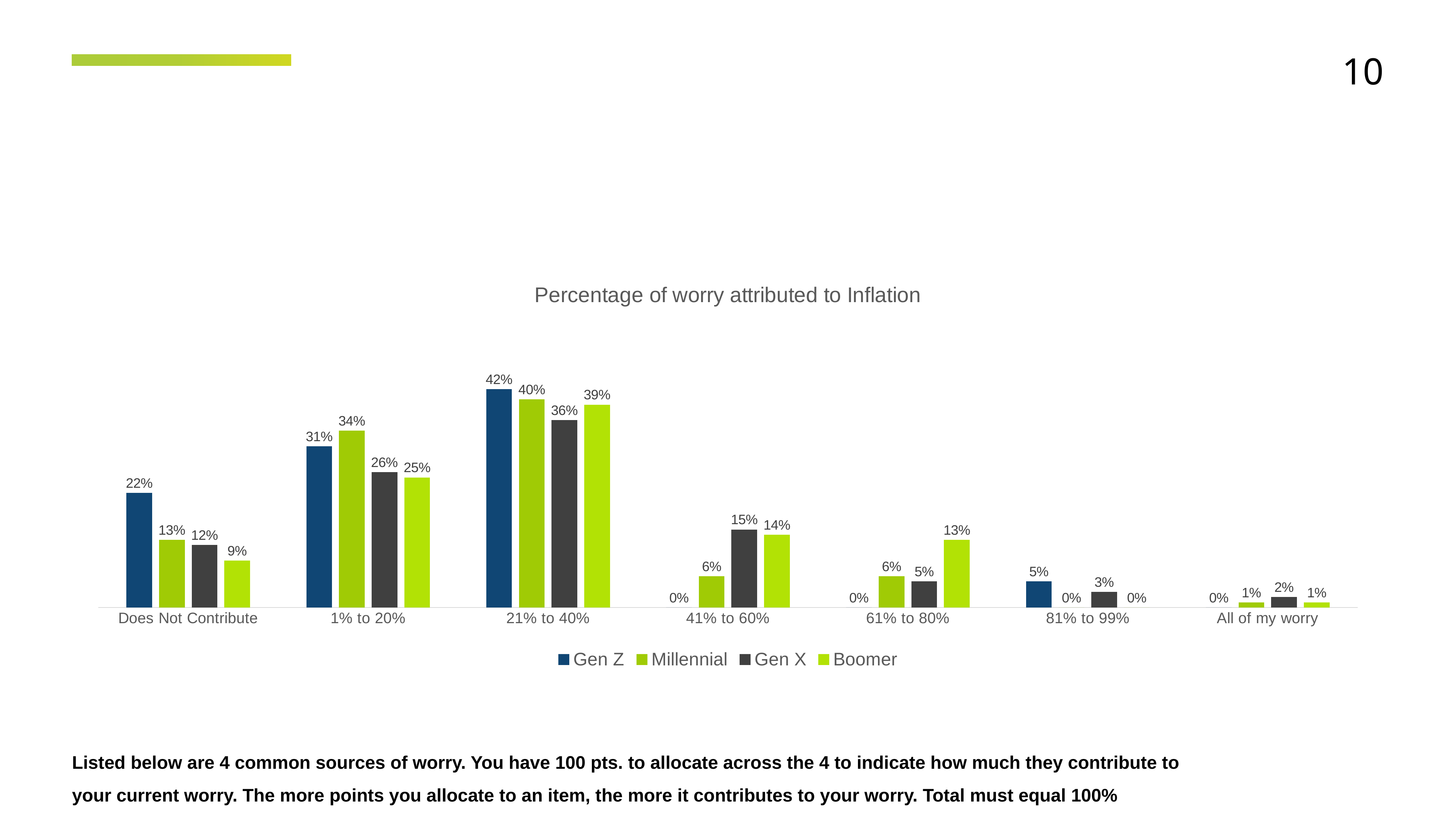
What is the Boomer value for the "Does Not Contribute" category? 9% What kind of chart is shown on the slide? Bar chart How many categories are shown on the x axis? 7 What is the Gen Z value for the "21% to 40%" category? 42% What is the Gen X value for the "41% to 60%" category? 15% Which category has the highest Gen Z value? 21% to 40% What is the title of the chart? Percentage of worry attributed to Inflation How many series does the legend list? 4 What is the Millennial value for the "1% to 20%" category? 34% In the "61% to 80%" category, which is larger: the Millennial value or the Boomer value? Boomer Which series has the lowest value in the "Does Not Contribute" category? Boomer What is the difference between the Gen Z and Gen X values in the "1% to 20%" category? 5%